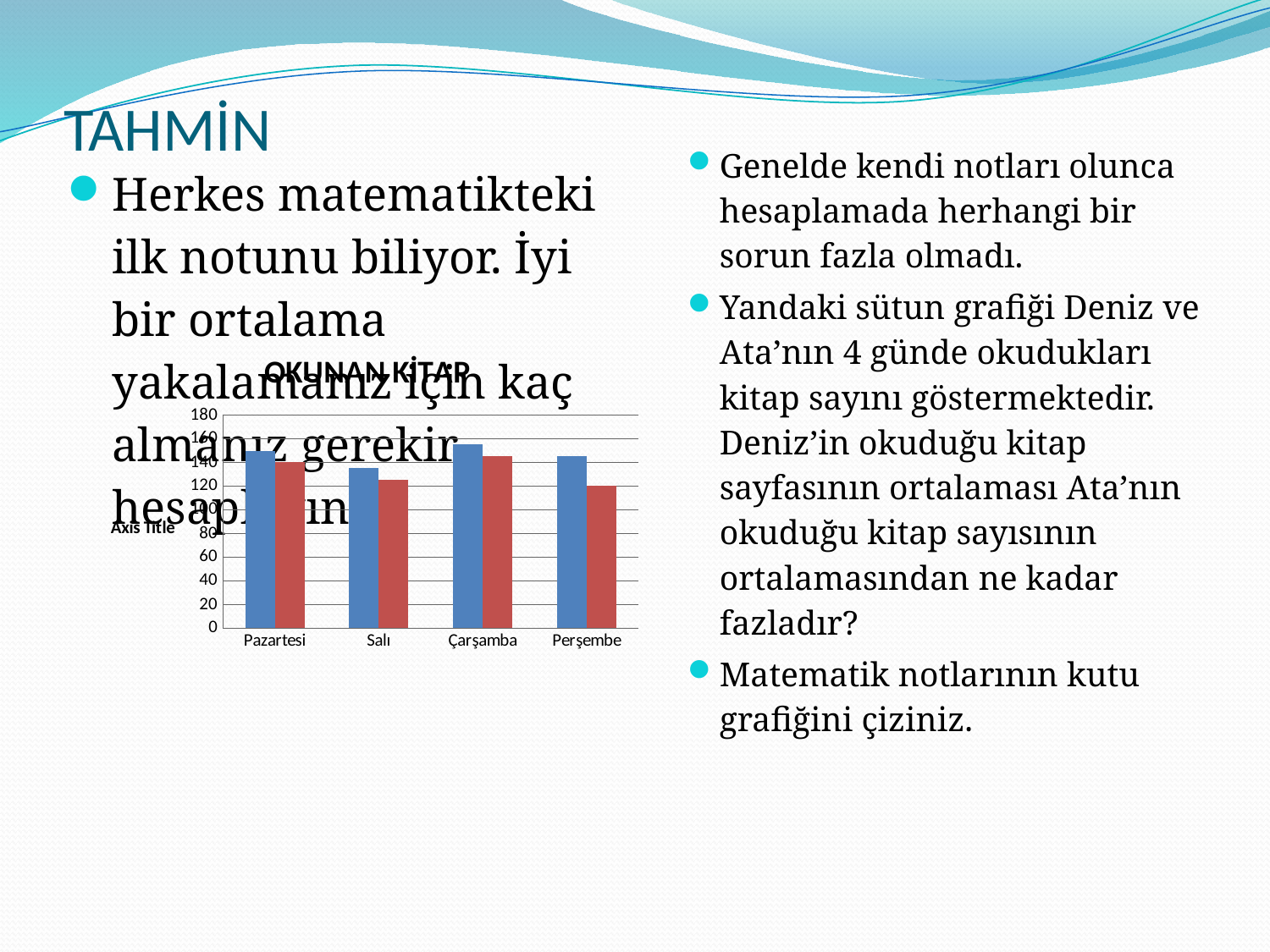
How many categories (days) are shown on the x axis of the chart? 4 Is the blue bar for Pazartesi greater or less than 140? greater Which day has the shortest blue bar? Salı What is the highest value shown on the chart's vertical axis? 180 What is the title of the chart? OKUNAN KİTAP For Pazartesi, which bar is taller, the blue one or the red one? blue What kind of chart is shown on the slide? bar chart Is the red bar for Salı greater or less than 140? less Which day has the tallest blue bar? Çarşamba Is the red bar for Perşembe greater or less than 140? less For Perşembe, which bar is taller, the blue one or the red one? blue